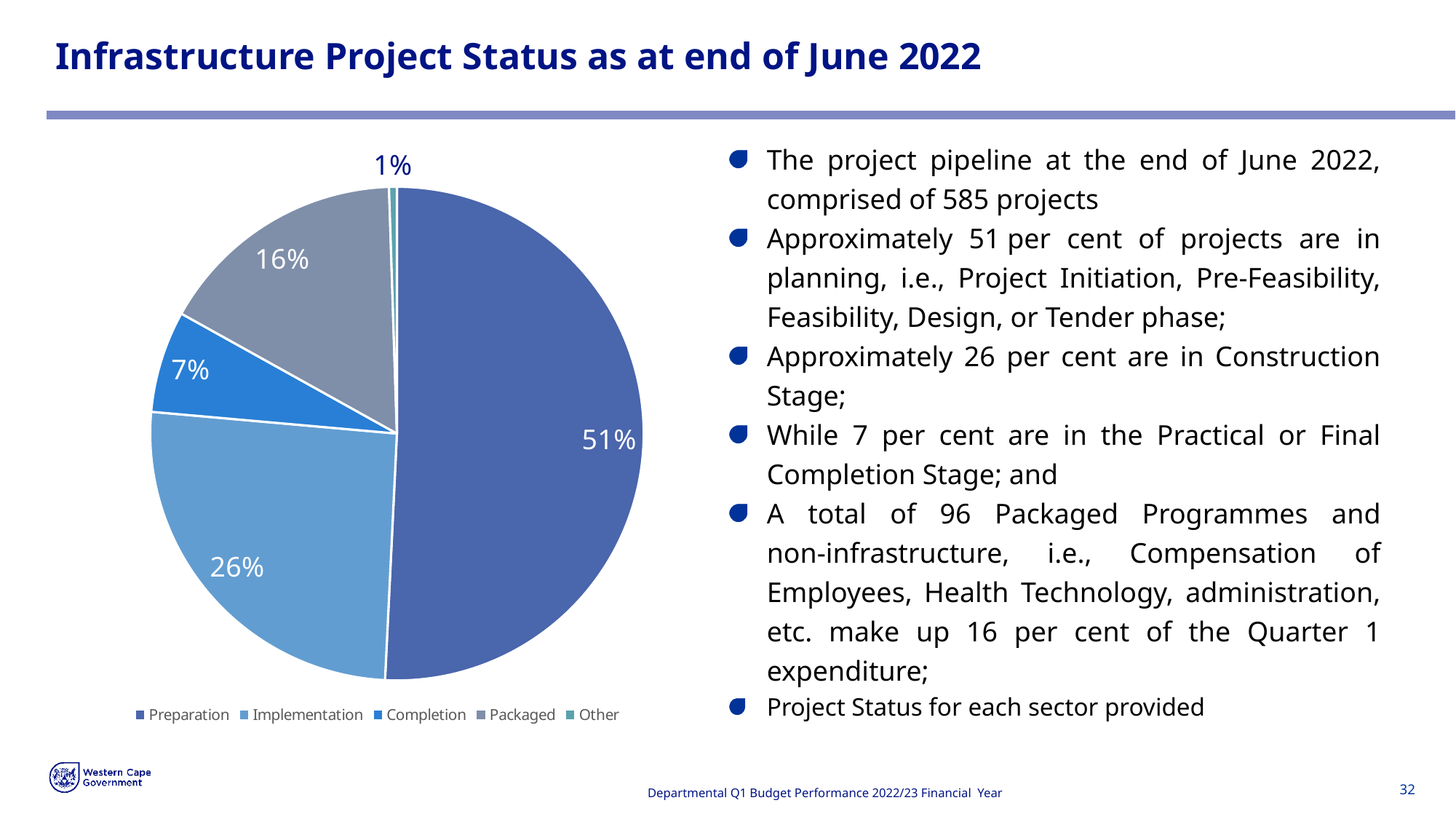
What percentage of projects are in the Implementation stage? 26% What is the difference in percentage points between the Preparation and Implementation slices? 25 What percentage of projects are in the Preparation stage? 51% How many categories does the legend list? 5 What type of chart is shown on the slide? pie chart What percentage is shown for the Other slice? 1% Which category has the smallest share of the pie? Other What colour is the Completion slice in the pie chart? blue What percentage of projects are in the Completion stage? 7% What percentage is shown for the Packaged slice? 16% Which category has the largest share of the pie? Preparation Which slice is larger, Packaged or Completion? Packaged